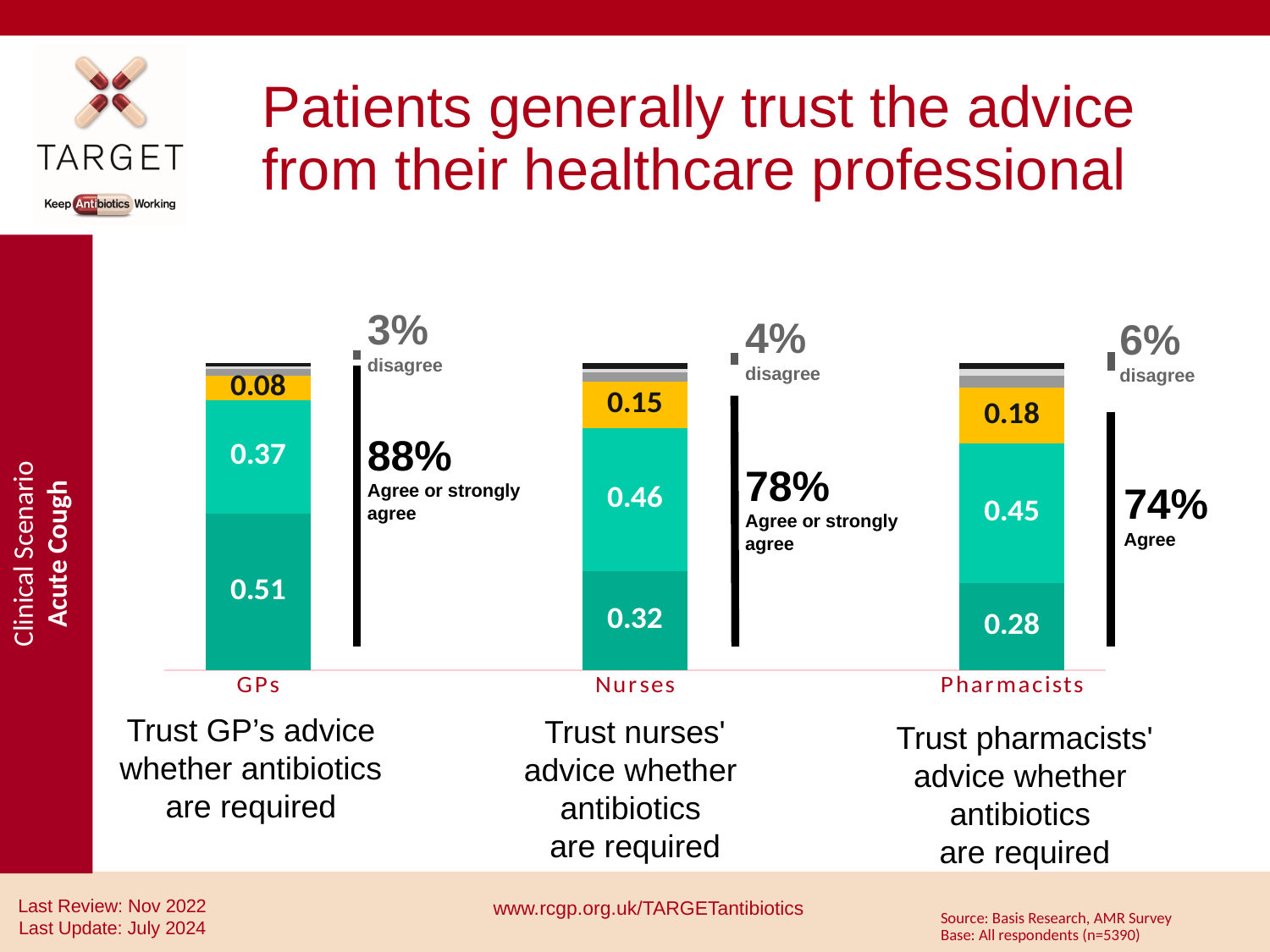
What is the value of the yellow segment of the Nurses bar? 0.15 What is the title of the slide containing the chart? Patients generally trust the advice from their healthcare professional What percentage of respondents agree or strongly agree that they trust GP's advice whether antibiotics are required? 88% Which category has the lowest value for the bottom (dark teal) segment? Pharmacists What is the value of the middle (light teal) segment of the Pharmacists bar? 0.45 Which is larger: the yellow segment for GPs or the yellow segment for Pharmacists? Pharmacists Which category has the highest 'agree or strongly agree' percentage? GPs How many categories are shown on the x axis of the chart? 3 What is the value of the bottom (dark teal) segment of the GPs bar? 0.51 What percentage of respondents disagree for Pharmacists? 6% What is the difference between the 'agree or strongly agree' percentages for GPs and Nurses? 10% What kind of chart is shown on the slide? stacked bar chart